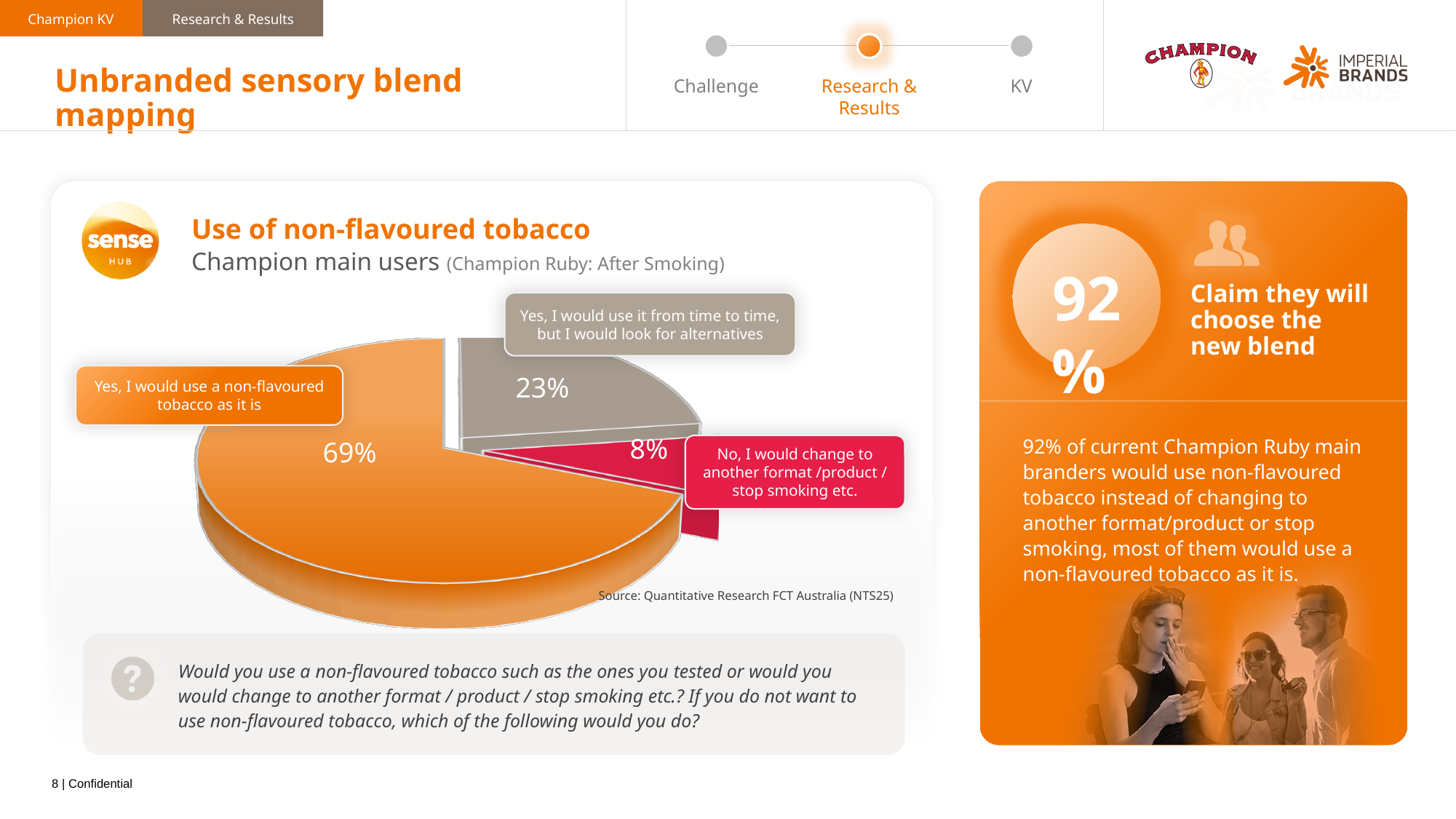
What is the combined share of the two 'Yes' responses? 92% What kind of chart is shown on the slide? Pie chart Which is larger: the share who would use it from time to time, or the share who would change to another format/product? Use it from time to time (23%) Which response has the smallest share of the pie? No, I would change to another format /product / stop smoking etc. Which response has the largest share of the pie? Yes, I would use a non-flavoured tobacco as it is What is the title of the chart? Use of non-flavoured tobacco What share of Champion main users said they would use a non-flavoured tobacco as it is? 69% What is the difference in percentage points between the 'use it as it is' slice and the 'use it from time to time' slice? 46 percentage points What share of Champion main users said they would use it from time to time but would look for alternatives? 23% What share of Champion main users said they would change to another format/product or stop smoking? 8% How many slices does the pie chart have? 3 What colour is the slice for 'No, I would change to another format /product / stop smoking etc.'? Red